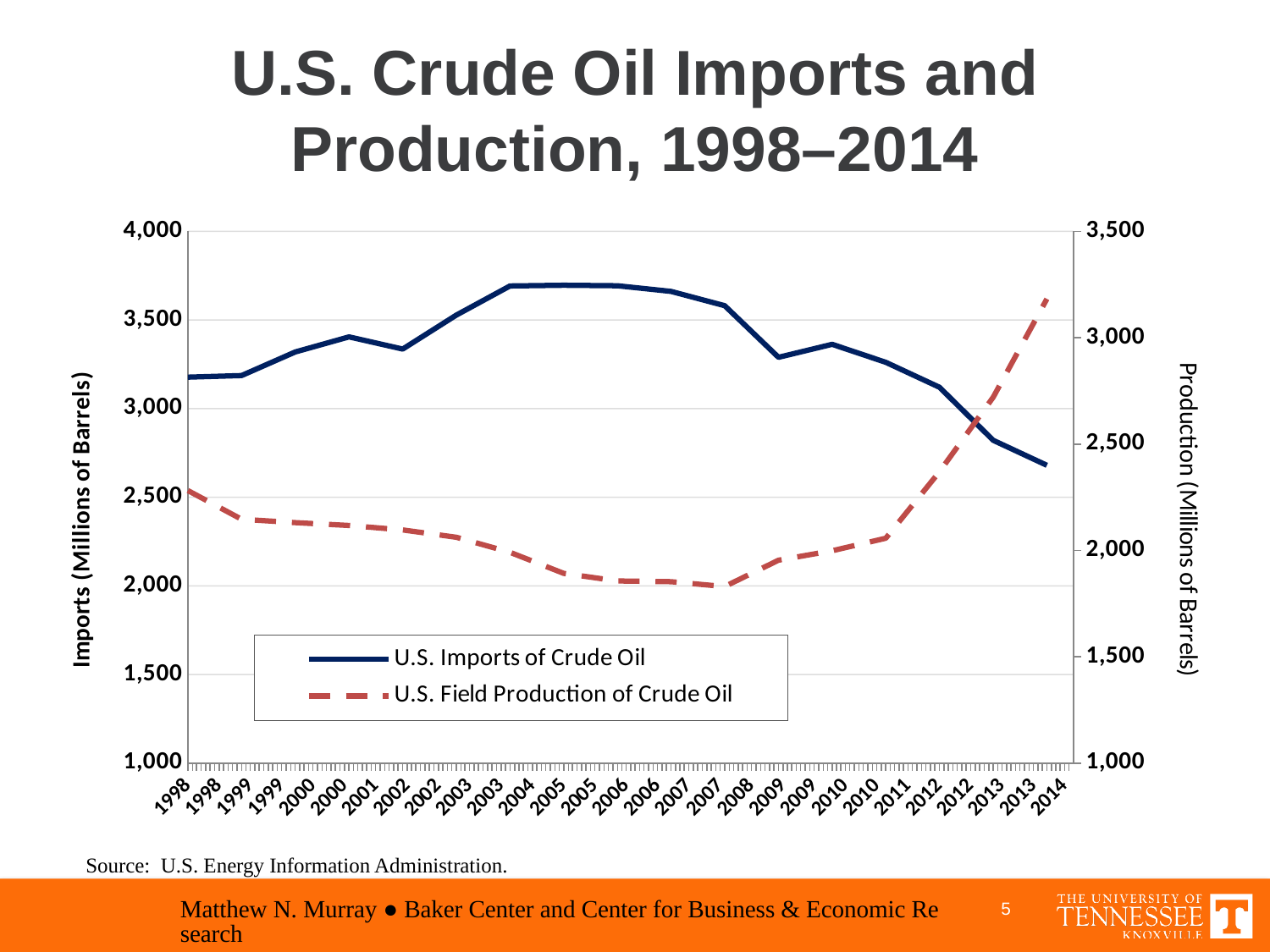
Is the value for U.S. Field Production of Crude Oil in 2007 greater or less than 2,000 on the right axis? less Is the value for U.S. Field Production of Crude Oil in 2014 greater or less than 3,000 on the right axis? greater How many series does the legend list? 2 Is the value for U.S. Imports of Crude Oil in 1998 greater or less than 3,000? greater In which year does U.S. Imports of Crude Oil reach its lowest value? 2014 What is the title of the left vertical axis? Imports (Millions of Barrels) Which series is drawn with a dashed line? U.S. Field Production of Crude Oil What kind of chart is shown on the slide? Line chart In which year does U.S. Field Production of Crude Oil reach its highest value? 2014 Does U.S. Field Production of Crude Oil rise or fall between 2008 and 2014? rise